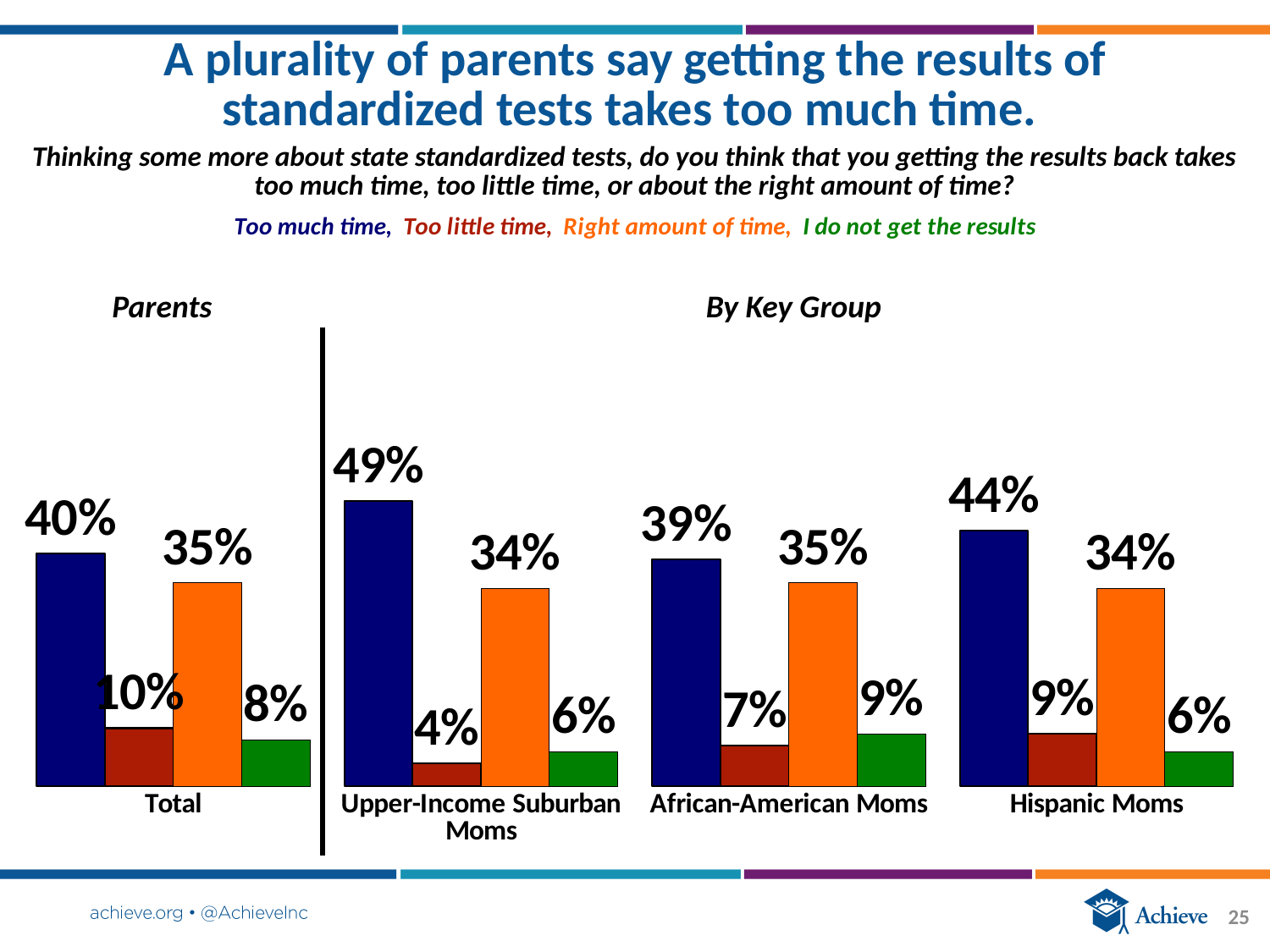
In the Parents chart, what percentage of the Total say getting the results takes too much time? 40% How many response categories (series) are shown for each group in the charts? 4 In the By Key Group chart, what is the difference between the share of Upper-Income Suburban Moms and African-American Moms who say getting the results takes too much time? 10 percentage points What type of chart is used on this slide? Bar chart In the By Key Group chart, what percentage of Hispanic Moms say getting the results takes too little time? 9% In the By Key Group chart, which group has the highest share saying getting the results takes too much time? Upper-Income Suburban Moms In the By Key Group chart, what percentage of Upper-Income Suburban Moms say getting the results takes too much time? 49% How many groups are shown in the By Key Group chart? 3 In the Parents chart, which is larger for the Total: the share saying too much time or the share saying the right amount of time? Too much time In the By Key Group chart, what percentage of African-American Moms say getting the results takes the right amount of time? 35% In the Parents chart, what percentage of the Total say they do not get the results? 8% In the By Key Group chart, which group has the lowest share saying getting the results takes too little time? Upper-Income Suburban Moms